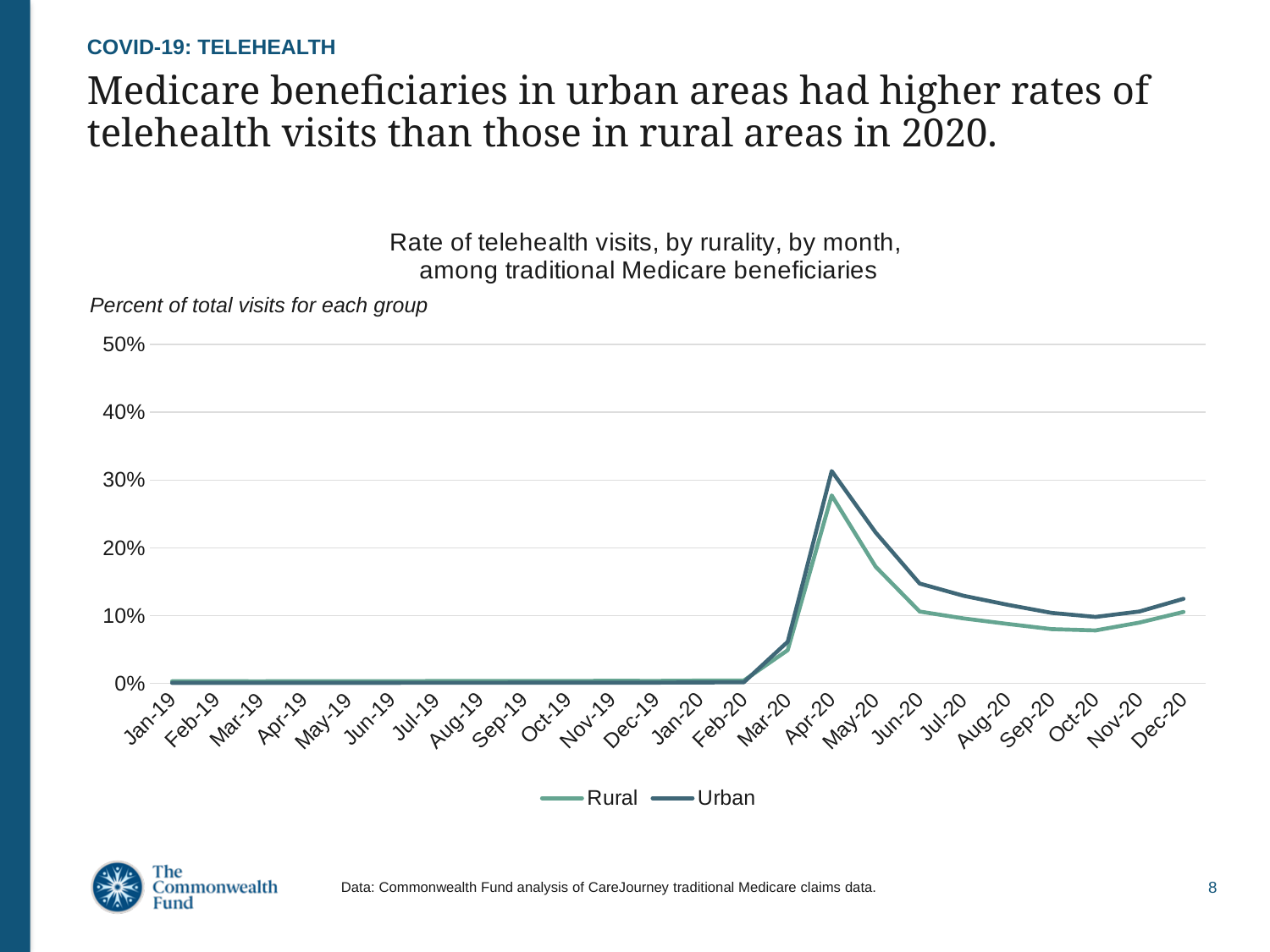
What is the title of the chart? Rate of telehealth visits, by rurality, by month, among traditional Medicare beneficiaries Is the value for Rural in Oct-20 greater or less than 10%? less How many series does the legend list? 2 In Apr-20, which series has the higher value, Rural or Urban? Urban Is the value for Urban in Dec-20 greater or less than 10%? greater In which month does the Rural line reach its highest value? Apr-20 In which month does the Urban line reach its highest value? Apr-20 How many months are plotted along the x axis? 24 Is the value for Urban in Jun-20 greater or less than 10%? greater What kind of chart is shown on the slide? line chart Do the values for Urban rise or fall from Apr-20 to Oct-20? fall